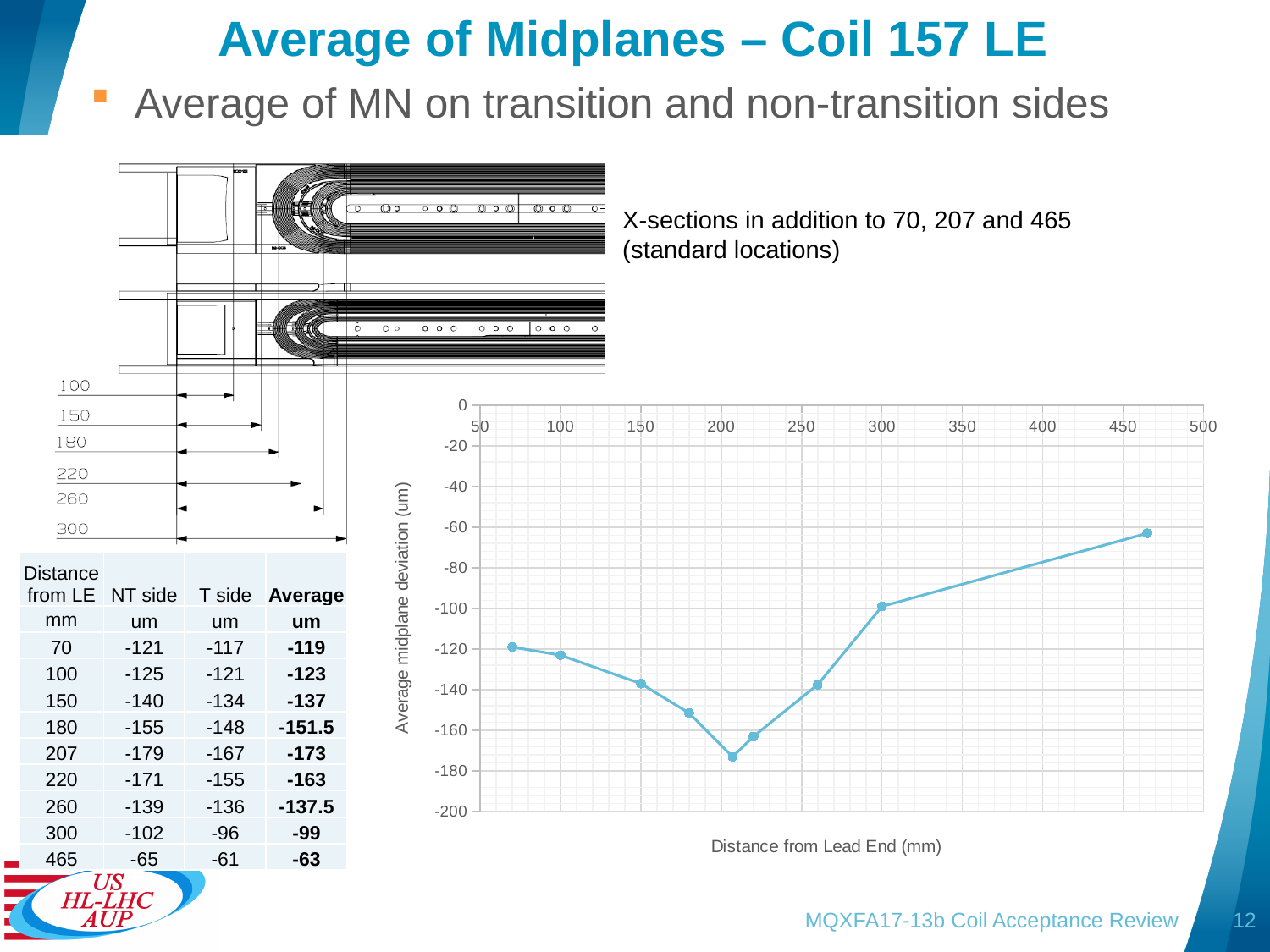
What is the label of the y axis of the chart? Average midplane deviation (um) What is the label of the x axis of the chart? Distance from Lead End (mm) Which has the larger (less negative) average midplane deviation: 100 mm or 300 mm from the lead end? 300 mm At which distance from the lead end is the average midplane deviation highest (closest to zero)? 465 mm How many data points are plotted on the line chart? 9 What kind of chart is shown on the slide? line chart Is the average midplane deviation at 207 mm greater or less than -160? less What is the average midplane deviation at 465 mm from the lead end? -63 um Does the average midplane deviation rise or fall between 207 mm and 465 mm from the lead end? rise At which distance from the lead end is the average midplane deviation lowest (most negative)? 207 mm Is the average midplane deviation at 465 mm greater or less than -80? greater What is the average midplane deviation at 207 mm from the lead end? -173 um